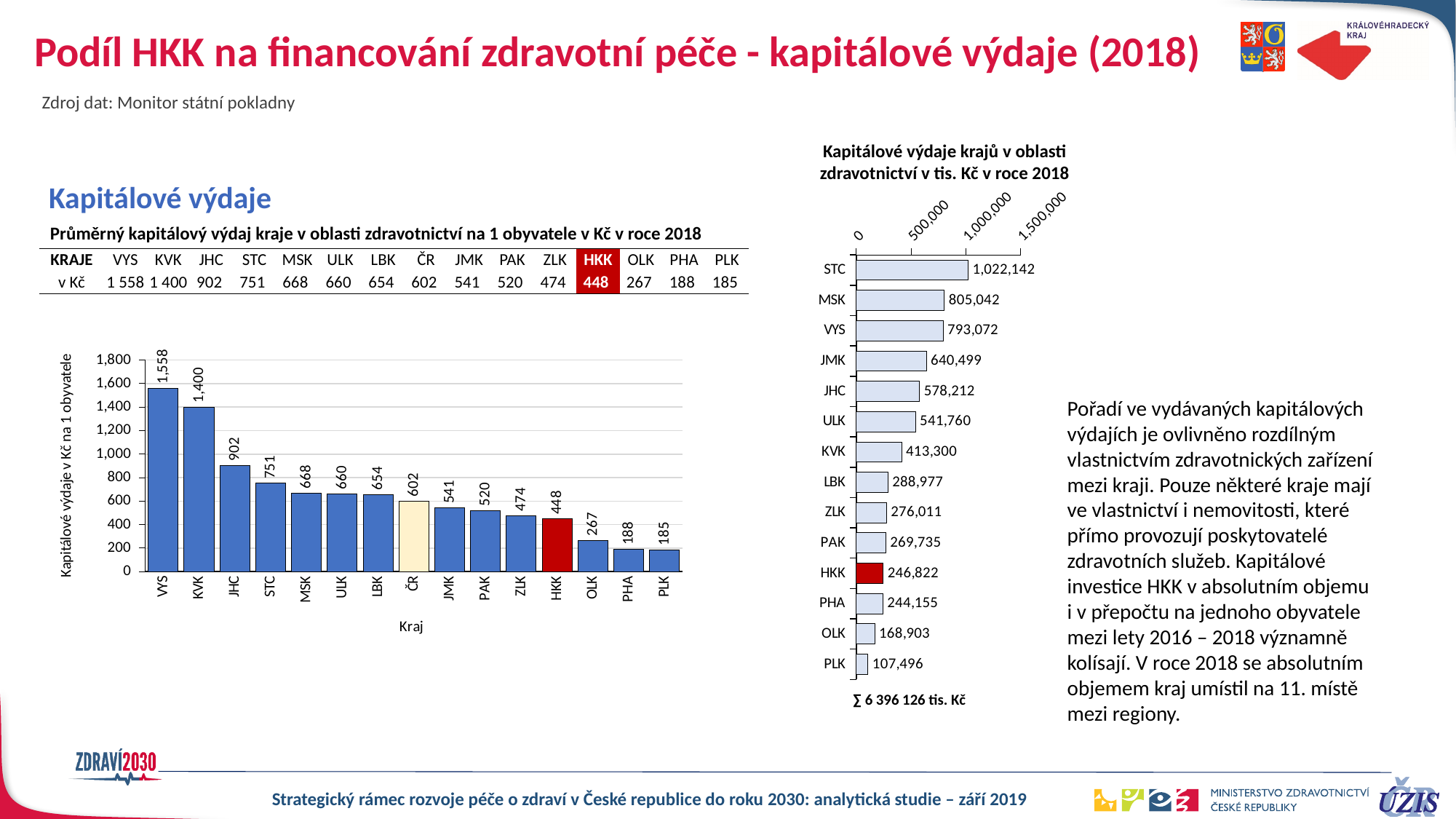
In the left bar chart, what is the value for ČR? 602 In the right chart titled 'Kapitálové výdaje krajů v oblasti zdravotnictví v tis. Kč v roce 2018', what is the value for HKK? 246,822 In the left bar chart, which region has the lowest value? PLK In the left bar chart (per-capita capital expenditure), what is the value for HKK? 448 In the right chart titled 'Kapitálové výdaje krajů v oblasti zdravotnictví v tis. Kč v roce 2018', how many regions are plotted? 14 In the right chart titled 'Kapitálové výdaje krajů v oblasti zdravotnictví v tis. Kč v roce 2018', which region has the highest value? STC In the left bar chart, how many bars are plotted? 15 In the left bar chart, what is the difference between the values for VYS and KVK? 158 In the right chart titled 'Kapitálové výdaje krajů v oblasti zdravotnictví v tis. Kč v roce 2018', what is the difference between the values for STC and PLK? 914,646 In the right chart titled 'Kapitálové výdaje krajů v oblasti zdravotnictví v tis. Kč v roce 2018', which is larger, the value for MSK or VYS? MSK What kind of chart is the right chart titled 'Kapitálové výdaje krajů v oblasti zdravotnictví v tis. Kč v roce 2018'? Bar chart In the left bar chart, which region has the highest value? VYS